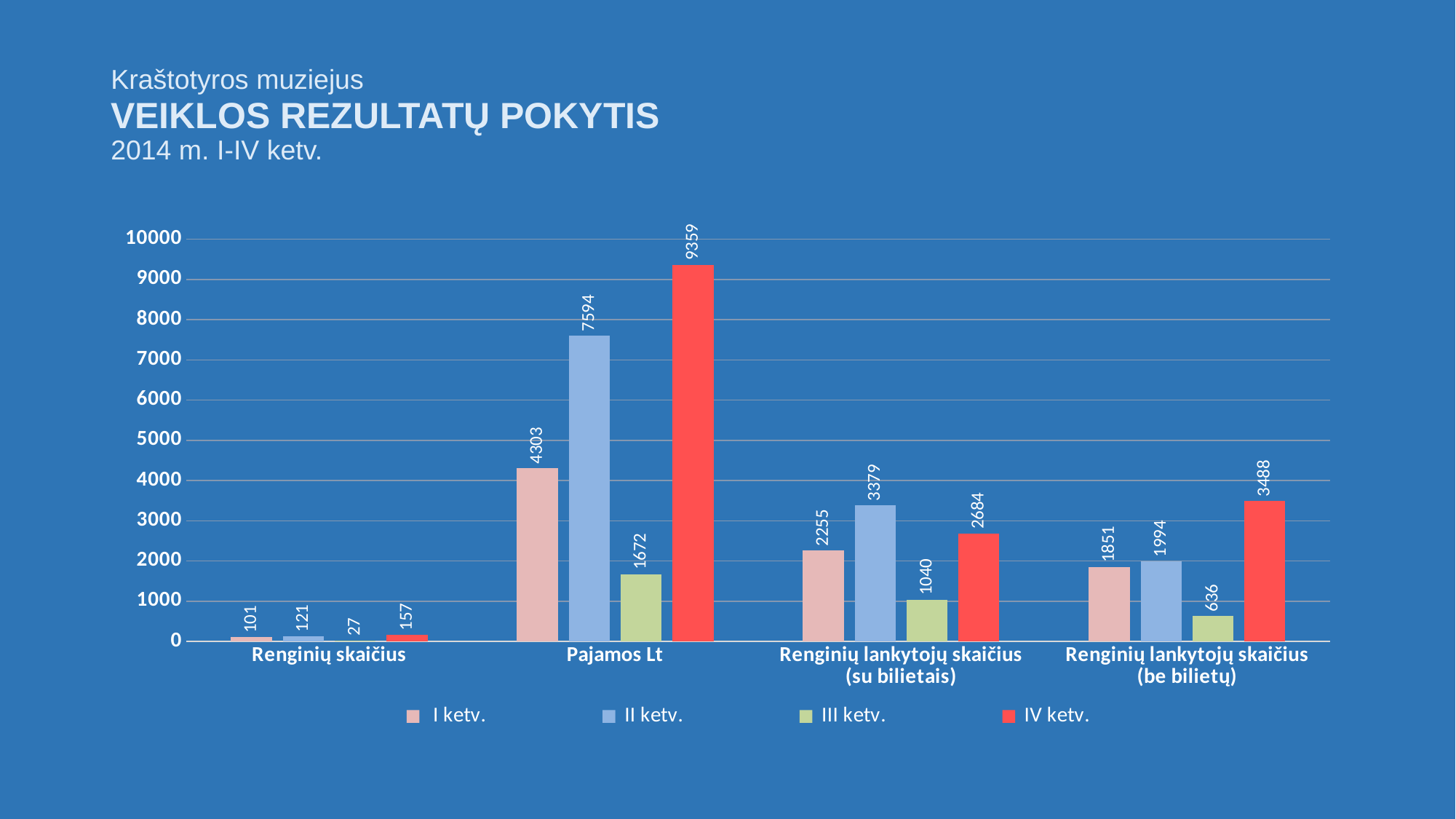
What is the value for IV ketv. in the Pajamos Lt category? 9359 What kind of chart is shown on the slide? Bar chart How many series does the legend list? 4 Is the value for II ketv. in the Pajamos Lt category greater or less than 7000? greater Which quarter has the highest value in the Renginių lankytojų skaičius (su bilietais) category? II ketv. What is the value for III ketv. in the Renginių skaičius category? 27 What is the value for I ketv. in the Renginių lankytojų skaičius (be bilietų) category? 1851 Which is larger in the Renginių lankytojų skaičius (su bilietais) category: I ketv. or IV ketv.? IV ketv. Which quarter has the lowest value in the Pajamos Lt category? III ketv. How many categories are shown on the x axis? 4 What is the difference between the II ketv. and I ketv. values in the Renginių lankytojų skaičius (be bilietų) category? 143 What is the difference between the IV ketv. and II ketv. values in the Pajamos Lt category? 1765